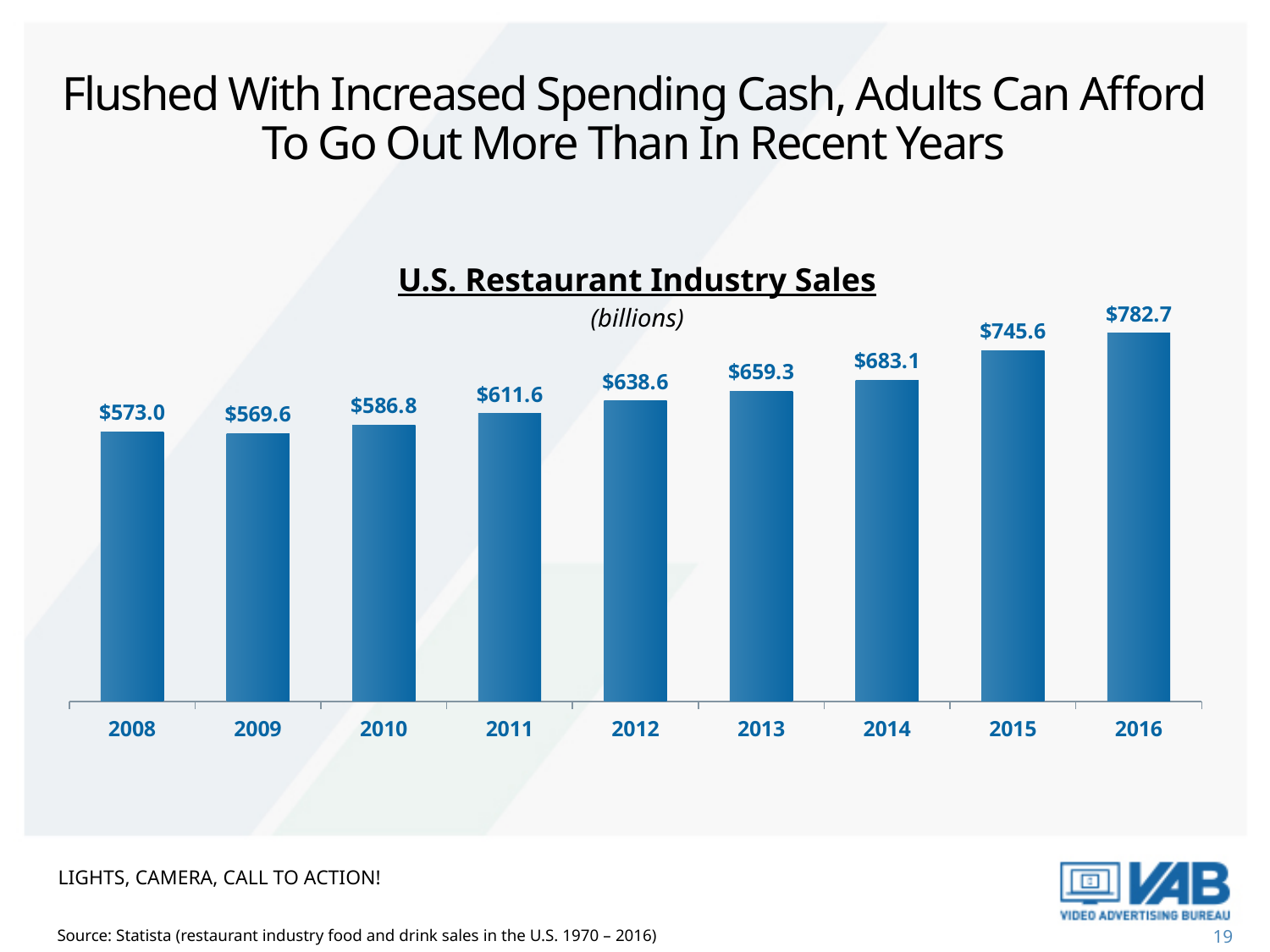
Which year has the lowest U.S. restaurant industry sales? 2009 How many years are shown in the U.S. Restaurant Industry Sales chart? 9 What is the difference in U.S. restaurant industry sales between 2008 and 2009? $3.4 What were U.S. restaurant industry sales in 2012? $638.6 What is the difference in U.S. restaurant industry sales between 2016 and 2015? $37.1 In what units are the values in the U.S. Restaurant Industry Sales chart expressed? Billions Which year has the highest U.S. restaurant industry sales? 2016 What were U.S. restaurant industry sales in 2009? $569.6 What were U.S. restaurant industry sales in 2016? $782.7 Which year had higher U.S. restaurant industry sales, 2013 or 2014? 2014 What kind of chart is used to show U.S. Restaurant Industry Sales? Bar chart Do U.S. restaurant industry sales generally rise or fall from 2009 to 2016? Rise